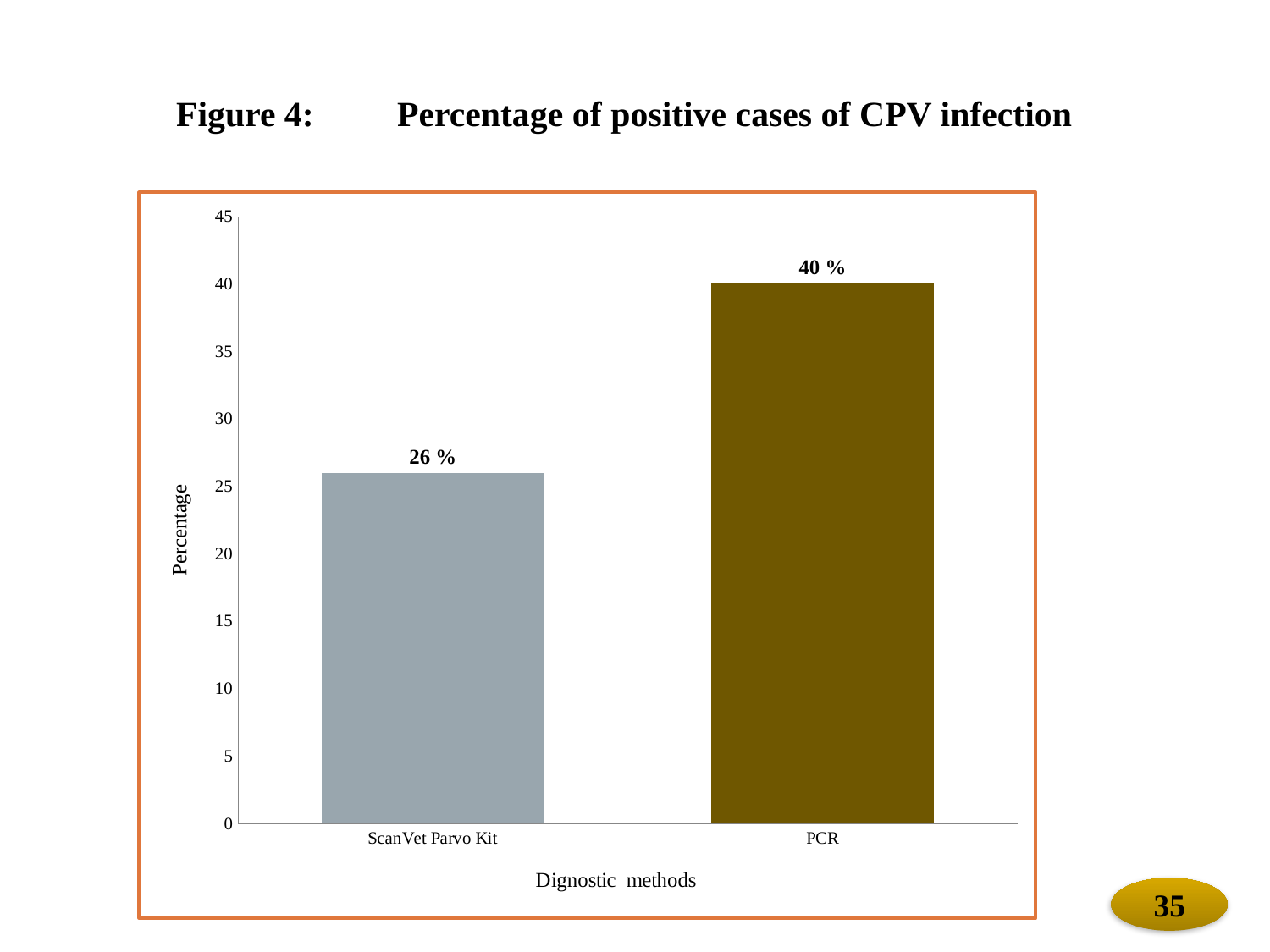
What kind of chart is shown on the slide? bar chart Which diagnostic method has the highest percentage of positive cases? PCR How many diagnostic methods are shown on the chart? 2 Which diagnostic method has the lowest percentage of positive cases? ScanVet Parvo Kit What is the percentage of positive cases for PCR? 40 % What is the difference in percentage points between PCR and the ScanVet Parvo Kit? 14 What is the percentage of positive cases for the ScanVet Parvo Kit? 26 % Is the value for PCR greater or less than 35? greater What is the label of the x axis? Dignostic methods Is the value for the ScanVet Parvo Kit greater or less than 30? less Which has a larger percentage of positive cases, ScanVet Parvo Kit or PCR? PCR What is the label of the y axis? Percentage